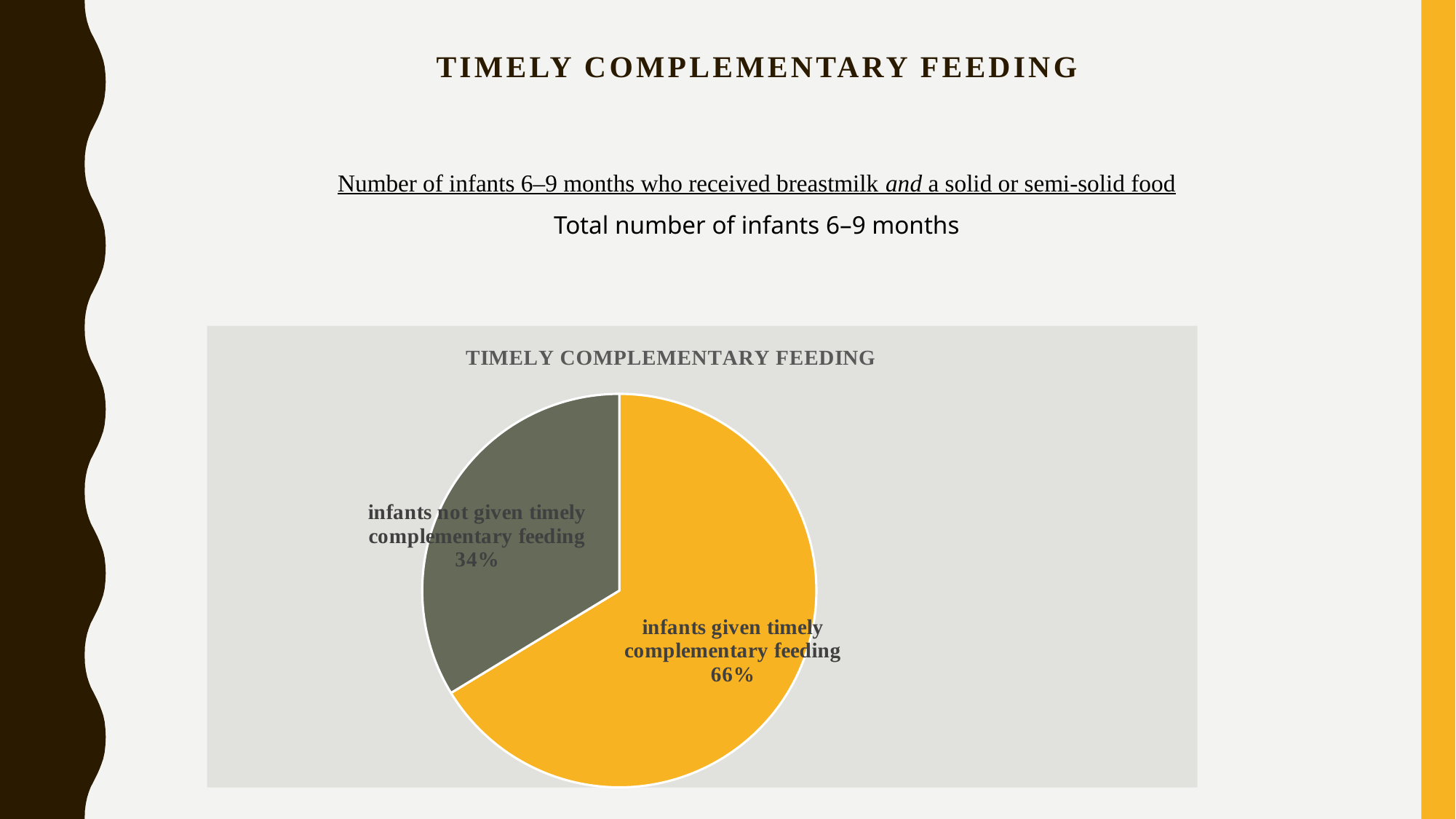
What percentage of infants were given timely complementary feeding? 66% Which slice of the pie is the smallest? infants not given timely complementary feeding What is the title of the chart? TIMELY COMPLEMENTARY FEEDING What share of the pie does the 'infants given timely complementary feeding' slice represent? 66% Which is larger: the share of infants given timely complementary feeding or the share not given timely complementary feeding? infants given timely complementary feeding What colour is the slice for infants not given timely complementary feeding? dark grey-green What percentage of infants were not given timely complementary feeding? 34% How many slices does the pie chart have? 2 Which slice of the pie is the largest? infants given timely complementary feeding What kind of chart is shown on the slide? pie chart What is the difference in percentage points between infants given timely complementary feeding and infants not given timely complementary feeding? 32